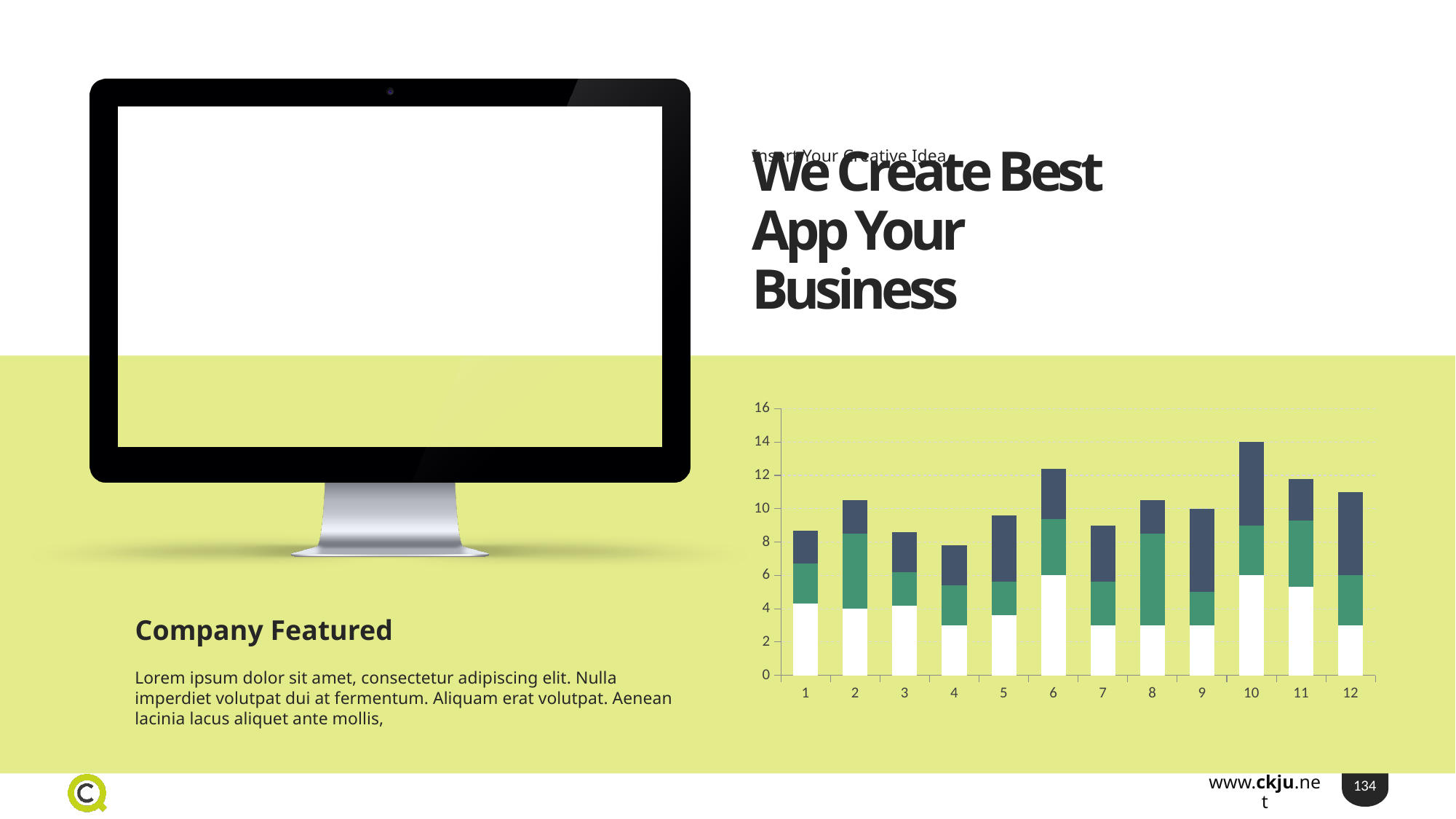
Is the total height of the bar for category 12 greater or less than 10? greater How many stacked segments does each bar in the chart have? 3 Which bar is taller, category 11 or category 3? 11 Which bar is taller, category 6 or category 7? 6 Which category has the tallest stacked bar in the chart? 10 Which category has the shortest stacked bar in the chart? 4 Is the total height of the bar for category 6 greater or less than 12? greater How many categories are shown on the x axis of the chart? 12 What kind of chart is shown on the slide? Stacked bar chart Is the total height of the bar for category 5 greater or less than 10? less